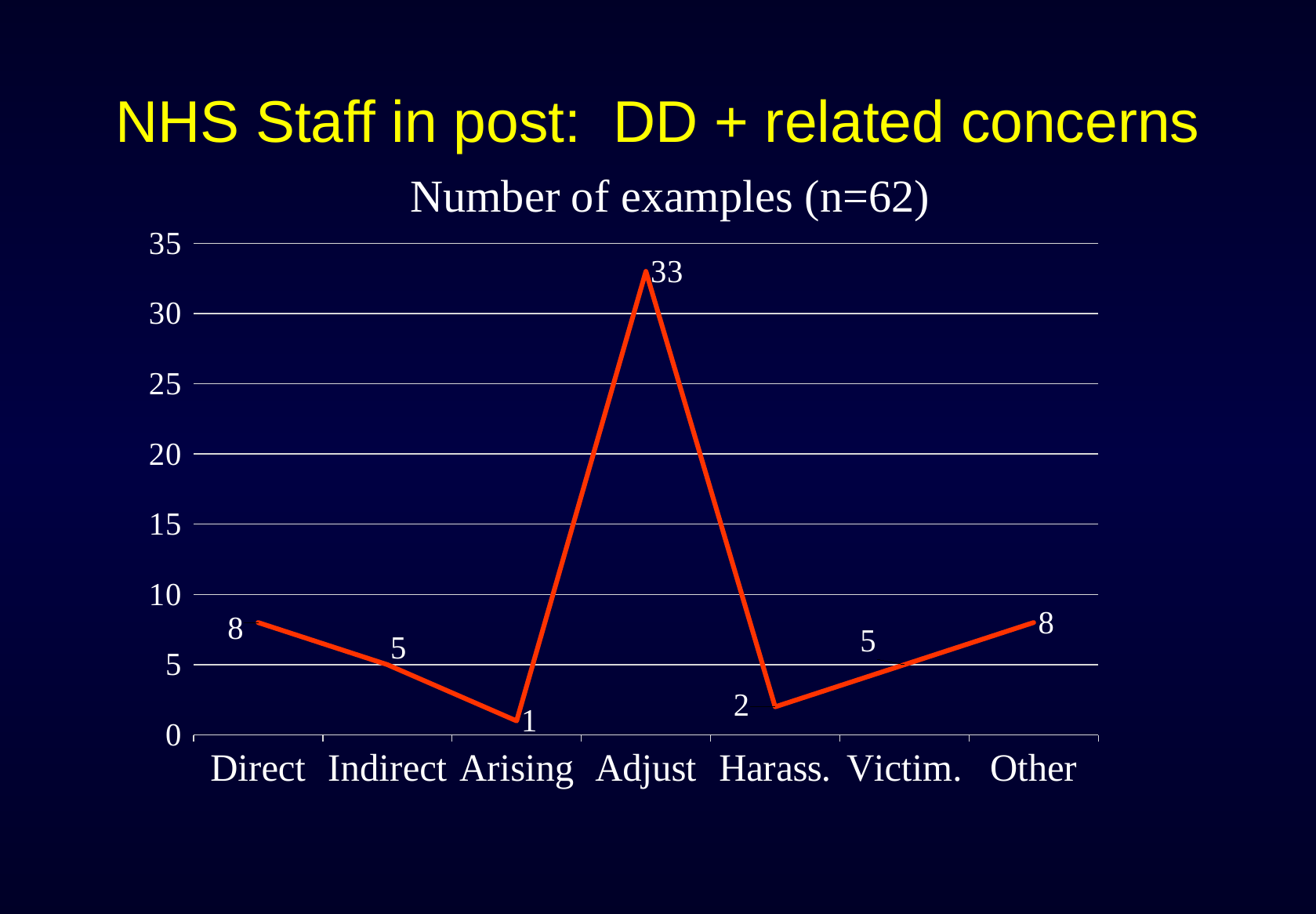
Which category has the highest value? Adjust How many categories are shown on the x axis? 7 Which is larger, the value for Victim. or the value for Harass.? Victim. What is the chart's title? Number of examples (n=62) Which category has the lowest value? Arising What is the difference between the values for Adjust and Direct? 25 Do the values rise or fall from Direct to Arising? fall What kind of chart is this? line chart What is the value for Harass.? 2 What is the value for Adjust? 33 What is the value for Arising? 1 Is the value for Adjust greater or less than 30? greater